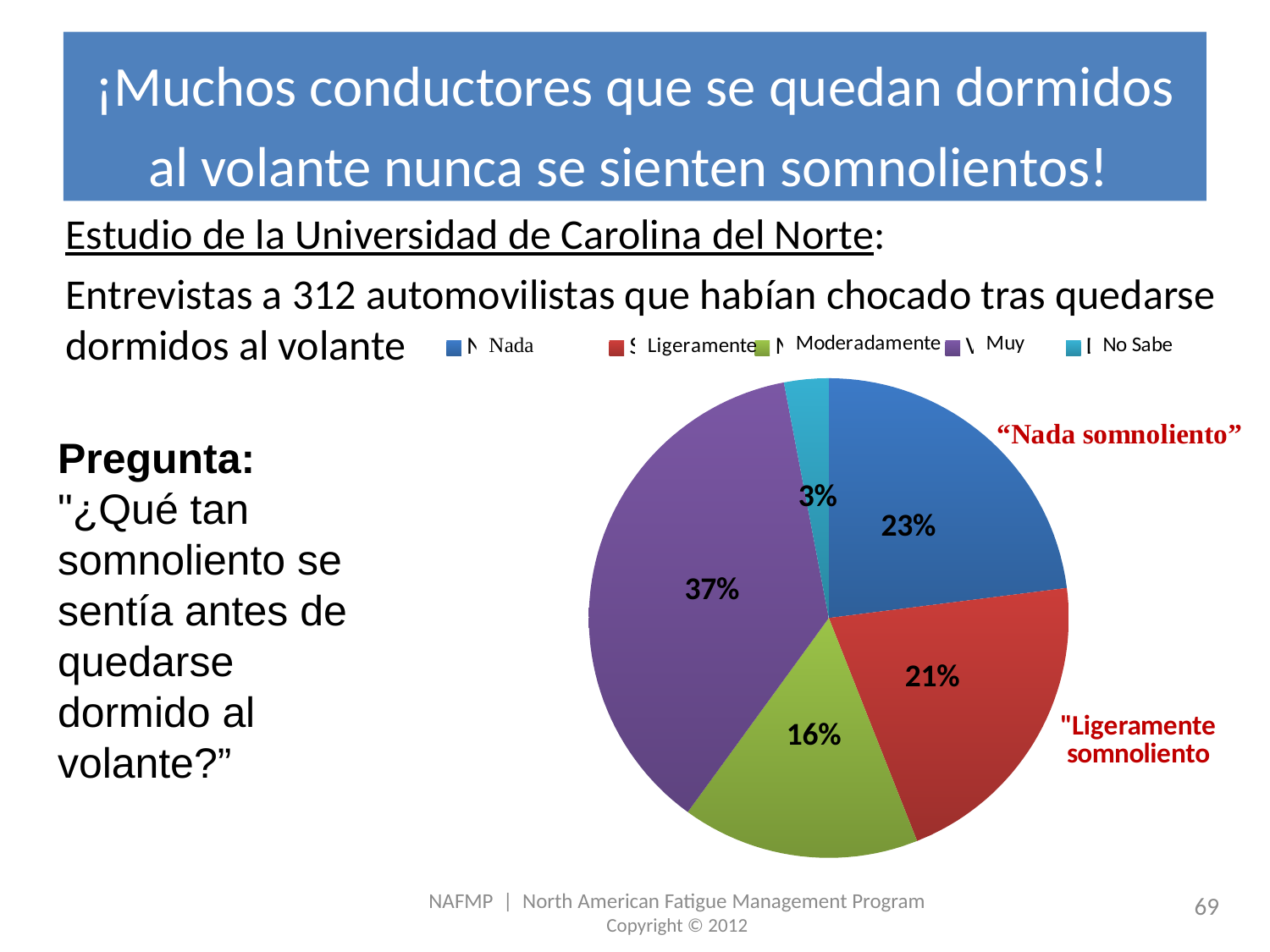
How many entries does the legend list? 5 What colour is the "Muy" slice of the pie? purple What percentage of the pie corresponds to "Nada"? 23% Which slice is larger, "Nada" or "Ligeramente"? Nada How many slices does the pie chart have? 5 Which category has the smallest slice of the pie? No Sabe What percentage of the pie corresponds to "No Sabe"? 3% What kind of chart is shown on the slide? pie chart What is the difference in percentage points between the "Muy" slice and the "Nada" slice? 14 What percentage of the pie corresponds to "Moderadamente"? 16% Which category has the largest slice of the pie? Muy What percentage of the pie corresponds to "Muy"? 37%